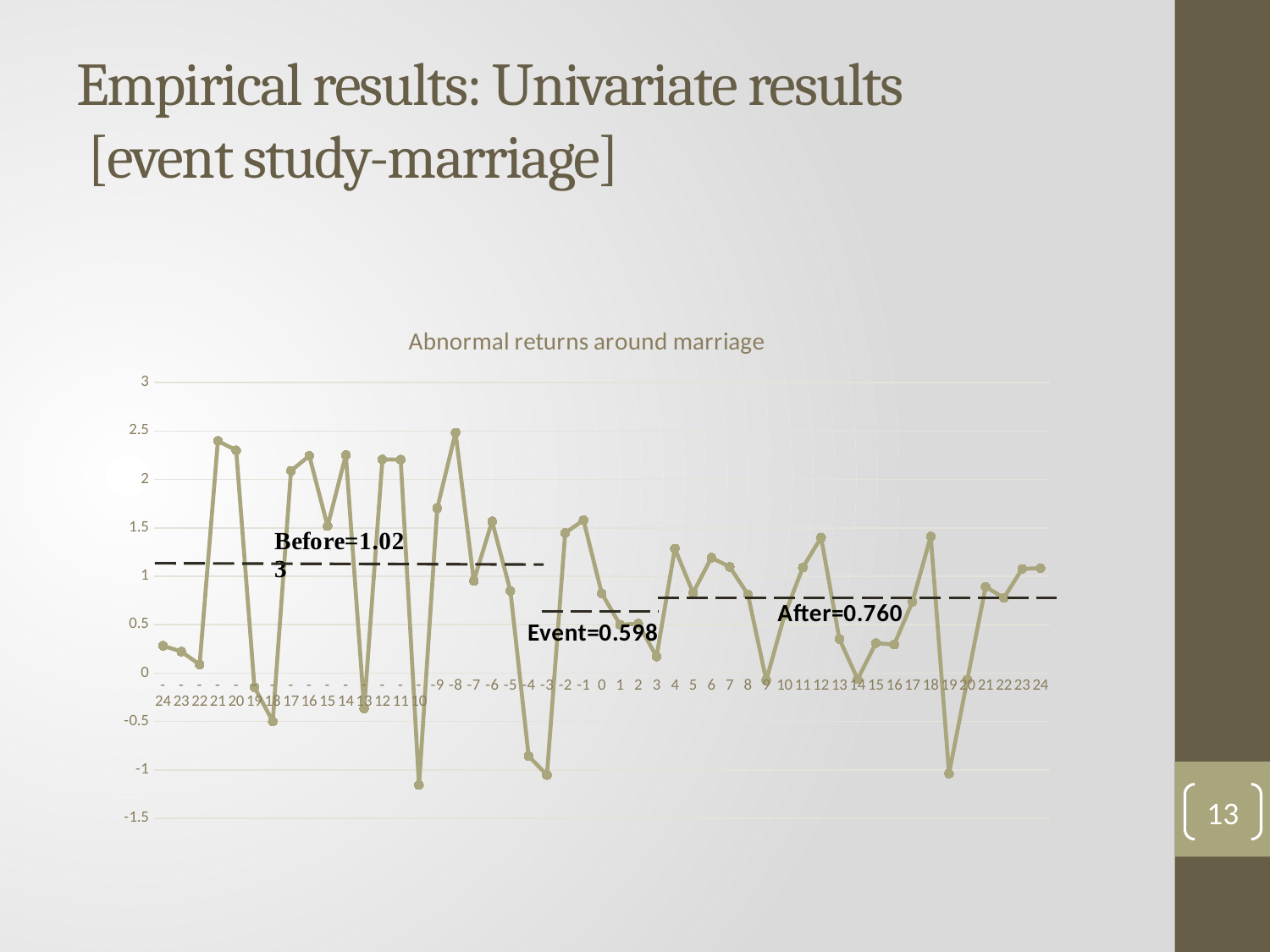
Is the value at x = 19 greater or less than -0.5? less Which of the three annotated averages (Before, Event, After) is the lowest? Event How many points are plotted on the x axis, from -24 to 24? 49 Which is larger, the value at x = -21 or the value at x = -19? x = -21 What is the title of the chart? Abnormal returns around marriage Is the value at x = 3 greater or less than 0.5? less Is the value at x = -21 greater or less than 2? greater What value is given for the 'Event' in the chart annotation? 0.598 What value is given for the 'After' period in the chart annotation? 0.760 What value is given for the 'Before' period in the chart annotation? 1.023 What kind of chart is shown on the slide? line chart Which of the three annotated averages (Before, Event, After) is the highest? Before